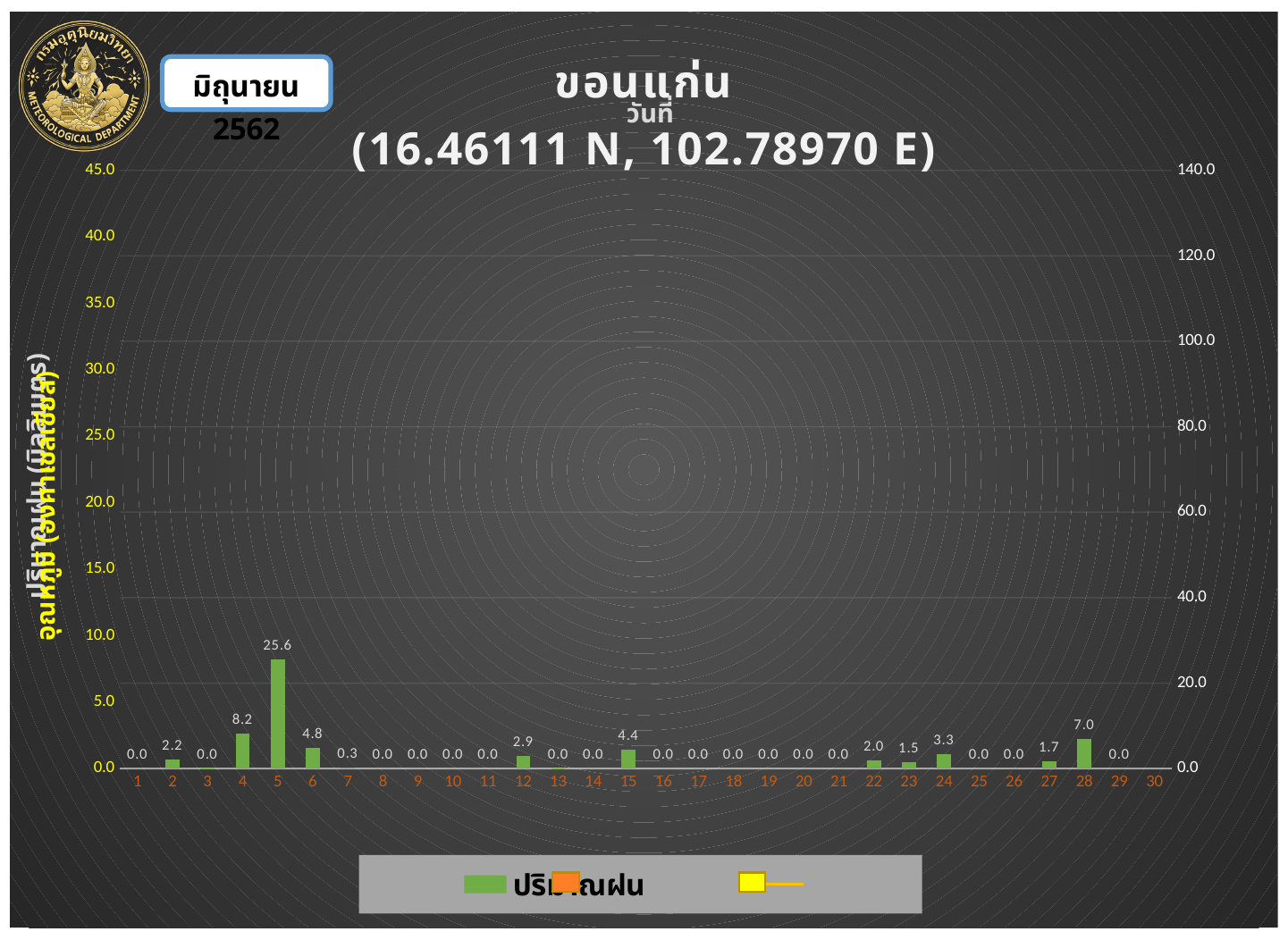
What station name is shown in the chart title? ขอนแก่น Which day has the highest rainfall value? 5 What is the rainfall value for day 15? 4.4 How many days are shown on the x axis? 30 Which has the larger rainfall value, day 24 or day 22? day 24 What is the rainfall value for day 28? 7.0 What is the rainfall value for day 5? 25.6 What is the difference between the rainfall values for day 5 and day 4? 17.4 Which has the larger rainfall value, day 6 or day 15? day 6 What is the rainfall value for day 4? 8.2 What kind of chart is shown on the slide? bar chart What is the difference between the rainfall values for day 28 and day 27? 5.3